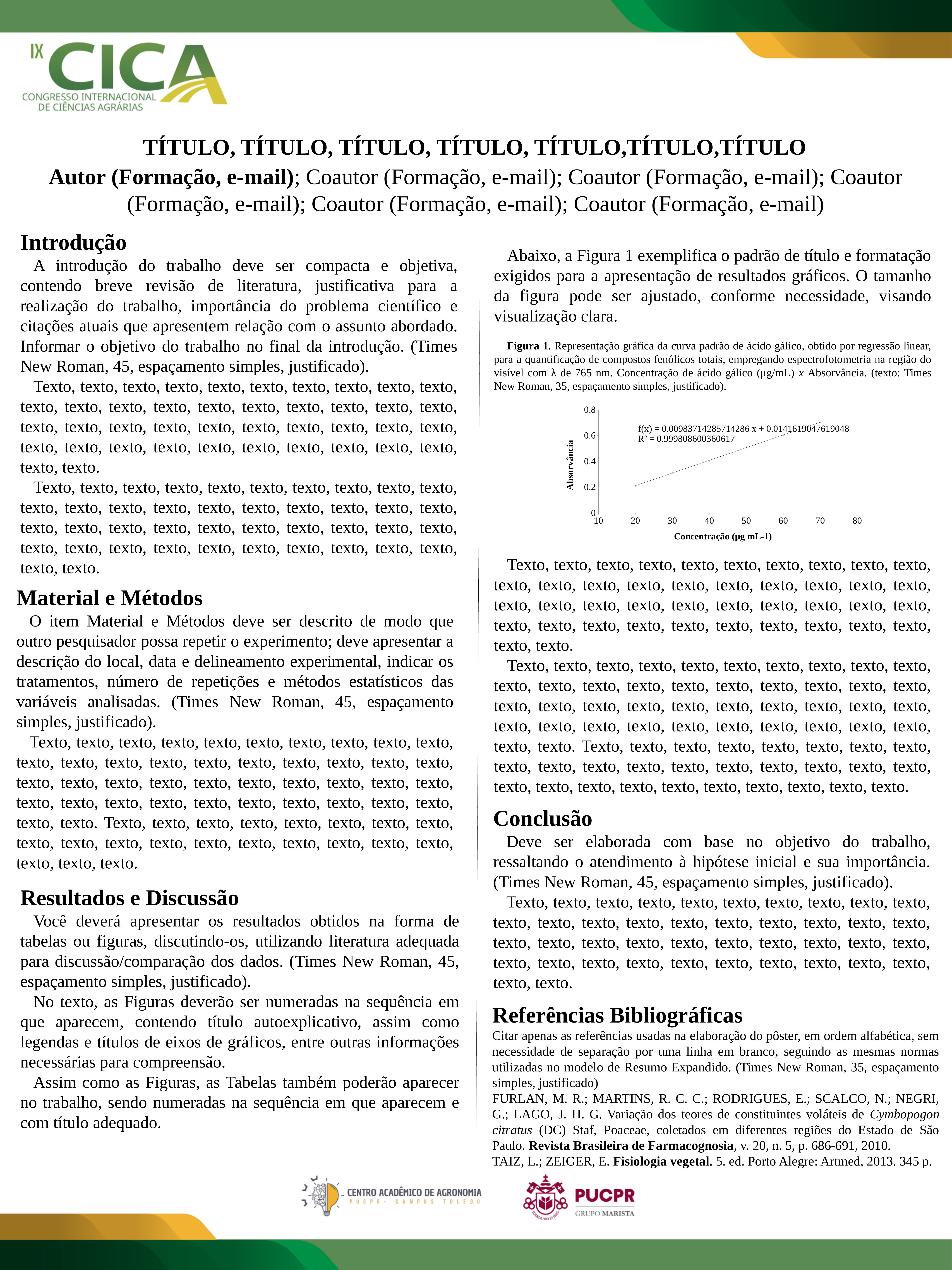
In Figura 1, at which plotted concentration is the absorbance lowest? 20 In Figura 1, at which plotted concentration is the absorbance highest? 70 What is the title of the x axis in Figura 1? Concentração (µg mL-1) In Figura 1, is the absorbance value at a concentration of 30 greater or less than 0.6? less How many data points are plotted in Figura 1? 6 What kind of chart is shown in Figura 1? scatter chart with a linear trendline What R² value is printed on the chart in Figura 1? R² = 0.999808600360617 In Figura 1, is the absorbance value at a concentration of 70 greater or less than 0.6? greater In Figura 1, is the absorbance value at a concentration of 20 greater or less than 0.4? less In Figura 1, do the absorbance values rise or fall as concentration increases along the x axis? rise In Figura 1, which has the higher absorbance: the point at concentration 20 or the point at concentration 70? the point at concentration 70